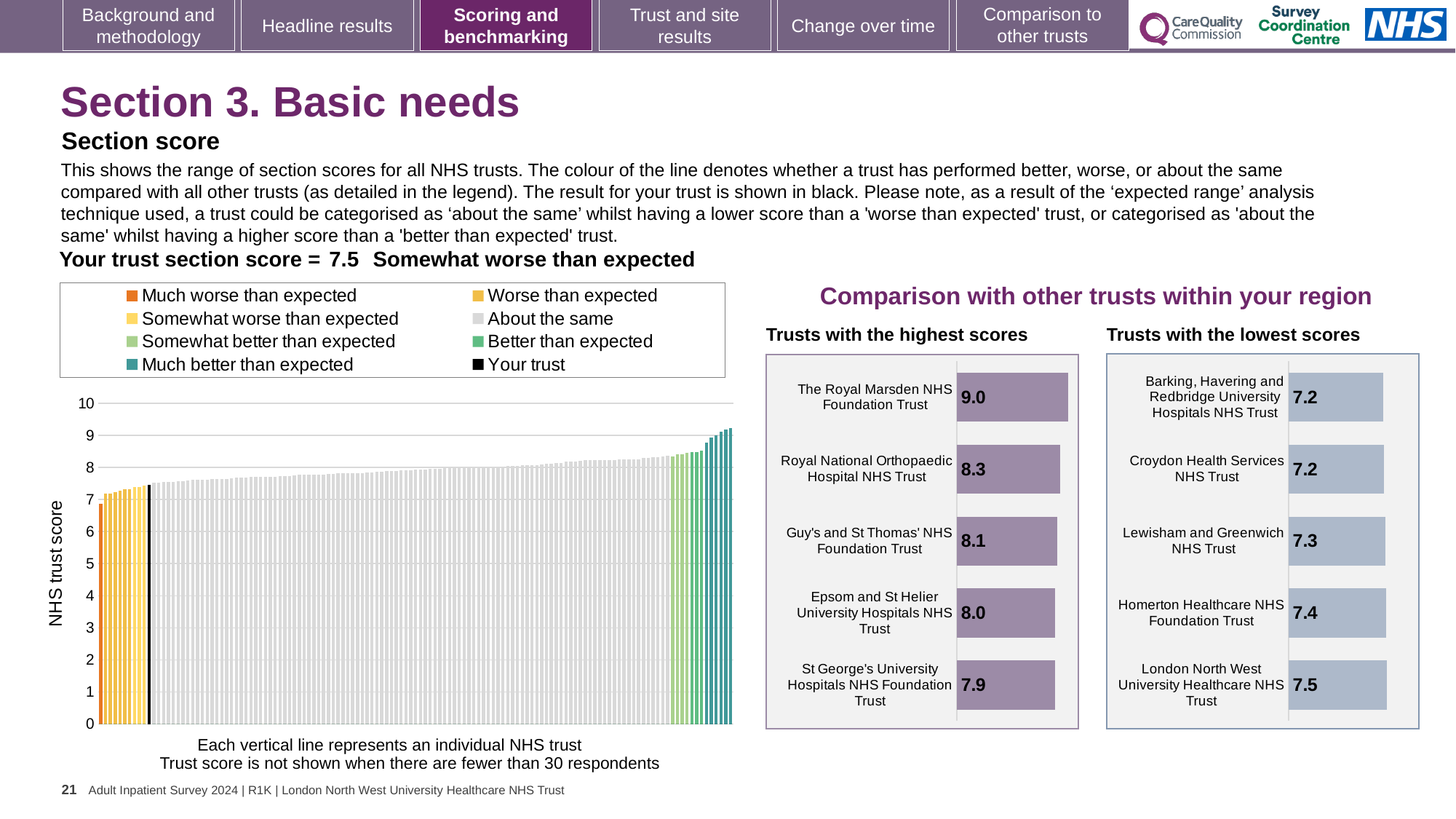
In the 'Trusts with the highest scores' chart, which trust has the highest score? The Royal Marsden NHS Foundation Trust In the 'Trusts with the lowest scores' chart, which trust has the highest score? London North West University Healthcare NHS Trust In the 'Trusts with the highest scores' chart, which trust has the lowest score? St George's University Hospitals NHS Foundation Trust How many trusts are shown in the 'Trusts with the highest scores' chart? 5 In the 'Trusts with the highest scores' chart, what is the difference between the scores of The Royal Marsden NHS Foundation Trust and St George's University Hospitals NHS Foundation Trust? 1.1 In the 'Trusts with the lowest scores' chart, what is the score for Lewisham and Greenwich NHS Trust? 7.3 In the main 'NHS trust score' chart, do the values rise or fall from left to right? Rise In the 'Trusts with the highest scores' chart, what is the score for The Royal Marsden NHS Foundation Trust? 9.0 How many entries does the legend of the main 'NHS trust score' chart list? 8 What is the section score for your trust shown on the slide? 7.5 In the 'Trusts with the lowest scores' chart, which has the higher score: Homerton Healthcare NHS Foundation Trust or Croydon Health Services NHS Trust? Homerton Healthcare NHS Foundation Trust What kind of chart is the main 'NHS trust score' chart on the left of the slide? Bar chart